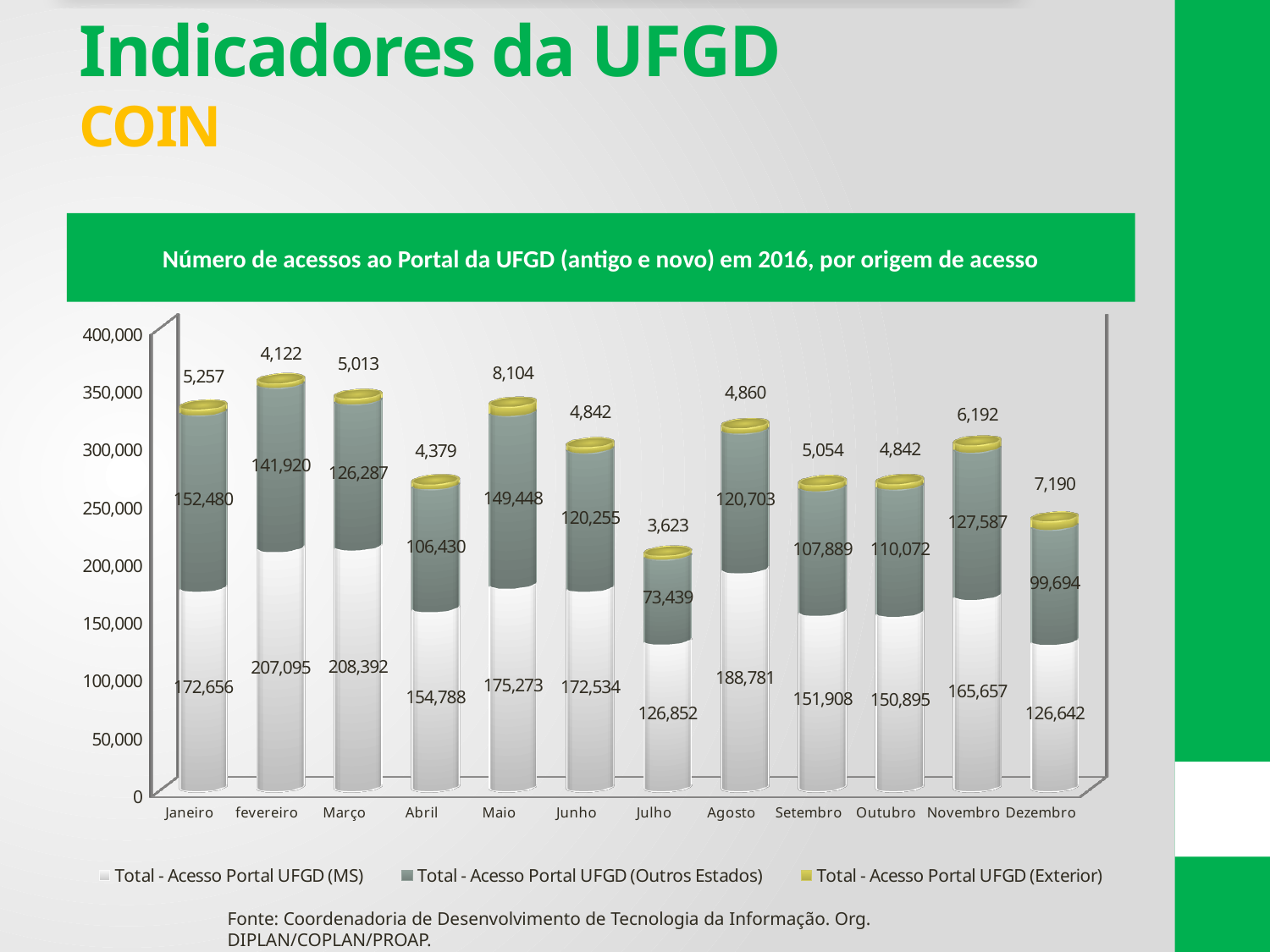
What is the total of the stacked bar for Janeiro? 330,393 What kind of chart is shown on the slide? stacked bar chart What is the value of Total - Acesso Portal UFGD (Exterior) for Dezembro? 7,190 Which is larger, the Total - Acesso Portal UFGD (MS) value for Agosto or for Setembro? Agosto How many series does the legend list? 3 Which month has the lowest value for Total - Acesso Portal UFGD (Outros Estados)? Julho Is the total height of the stacked bar for Julho greater or less than 250,000? less How many months are shown on the x axis? 12 What is the value of Total - Acesso Portal UFGD (MS) for Março? 208,392 What is the difference between the Total - Acesso Portal UFGD (MS) values for fevereiro and Janeiro? 34,439 Which month has the highest value for Total - Acesso Portal UFGD (Exterior)? Maio What is the value of Total - Acesso Portal UFGD (Outros Estados) for Julho? 73,439